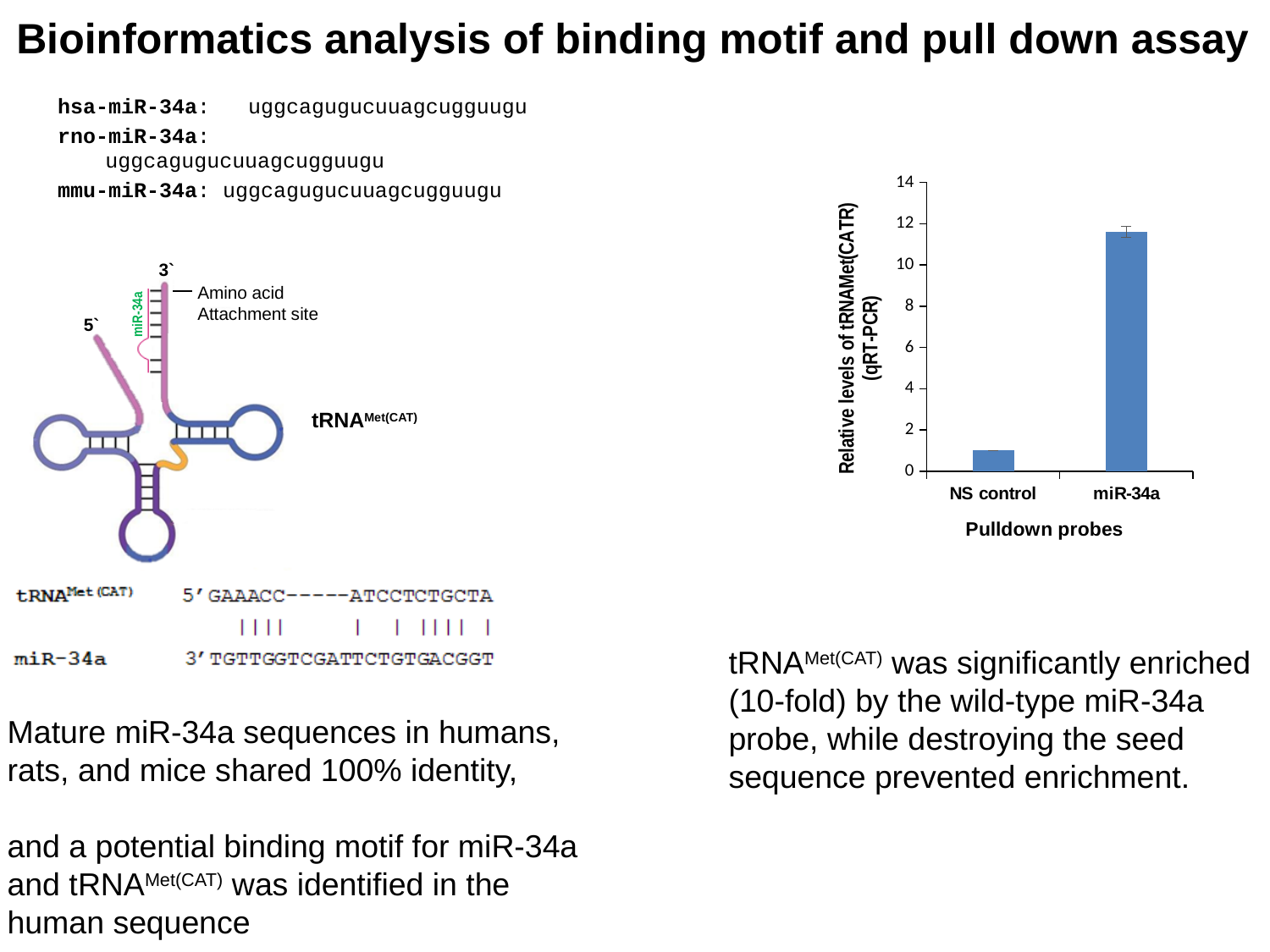
What kind of chart is shown on the slide? bar chart Is the value for miR-34a greater or less than 12? less Which is larger, the value for NS control or the value for miR-34a? miR-34a Do the values rise or fall from NS control to miR-34a along the x axis? rise Is the value for miR-34a greater or less than 10? greater Is the value for NS control greater or less than 2? less How many categories are shown on the x axis of the bar chart? 2 What is the maximum value shown on the y axis of the bar chart? 14 Which pulldown probe has the lowest relative level of tRNAMet(CATR)? NS control What is the label of the x axis of the bar chart? Pulldown probes Which pulldown probe has the highest relative level of tRNAMet(CATR)? miR-34a